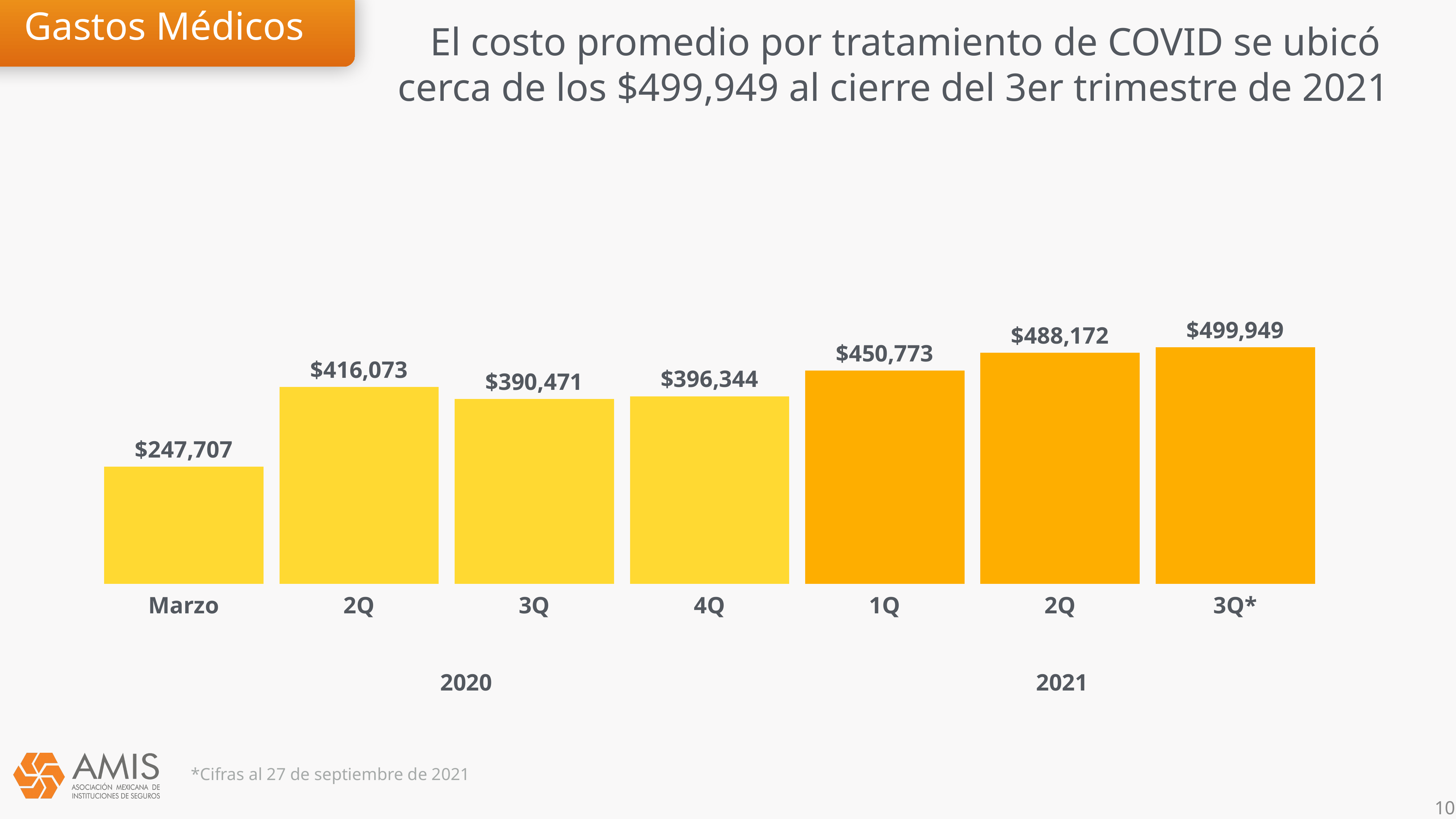
Do the values rise or fall from 4Q 2020 to 3Q* 2021? Rise What is the difference between the value for 3Q* 2021 and the value for Marzo 2020? $252,242 Which period has the lowest average cost? Marzo 2020 What is the difference between the value for 2Q 2021 and the value for 1Q 2021? $37,399 What is the value shown for 3Q* of 2021? $499,949 What is the average COVID treatment cost shown for Marzo 2020? $247,707 What kind of chart is shown on the slide? Bar chart What is the value shown for 1Q of 2021? $450,773 How many bars are plotted in the chart? 7 What is the value shown for 4Q of 2020? $396,344 Which is larger, the value for 2Q 2020 or the value for 3Q 2020? 2Q 2020 Which period has the highest average cost? 3Q* 2021